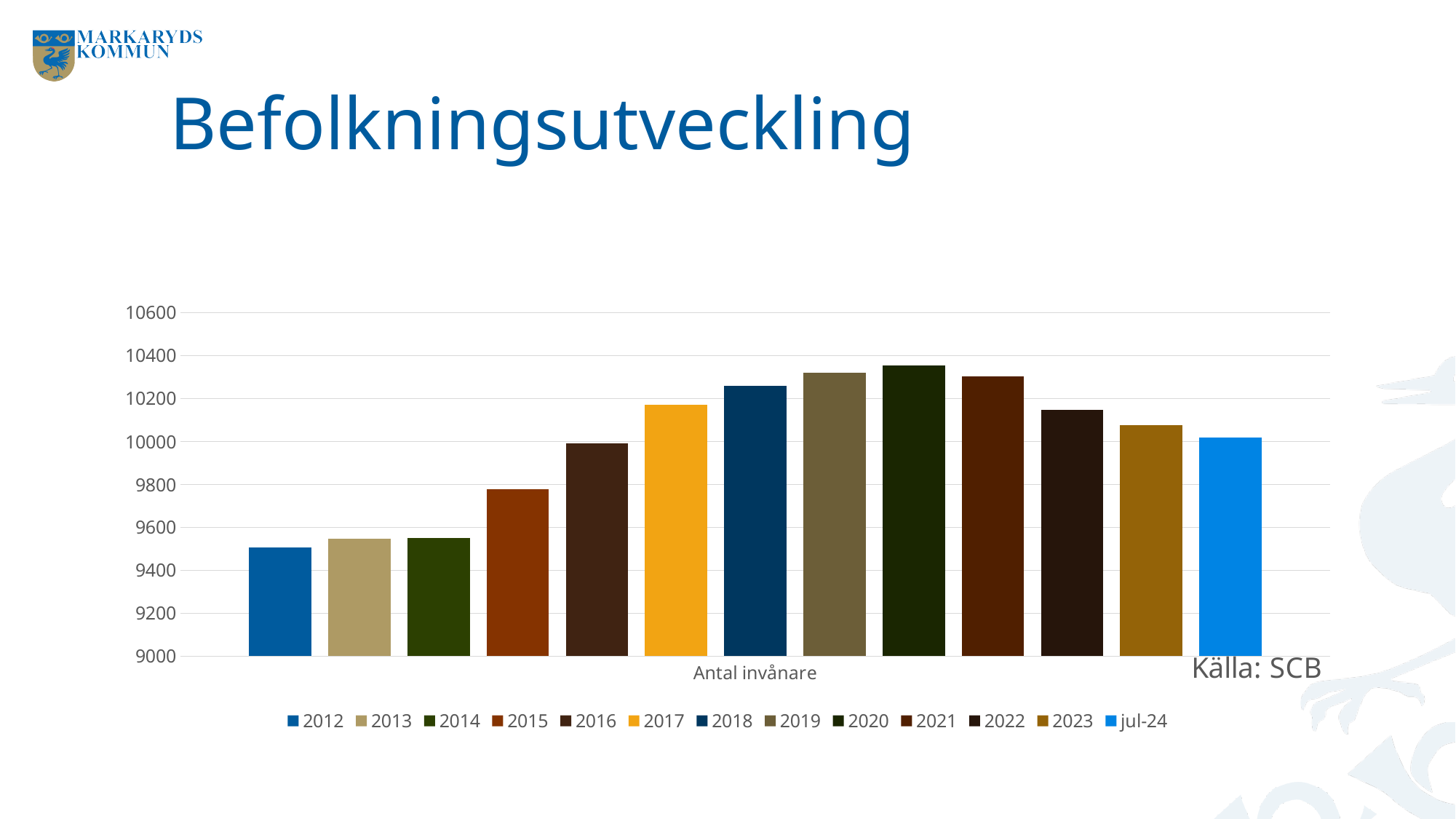
Which year has the lowest bar? 2012 How many series does the legend list? 13 Which year has the highest bar? 2020 Is the value for 2022 greater or less than 10200? less Is the value for 2014 greater or less than 9600? less Is the value for 2018 greater or less than 10200? greater Which is larger, the value for 2019 or the value for 2023? 2019 Do the values rise or fall from 2012 to 2020? rise How many bars are plotted in the chart? 13 What kind of chart is shown on the slide? bar chart What is the title of the chart on the slide? Befolkningsutveckling